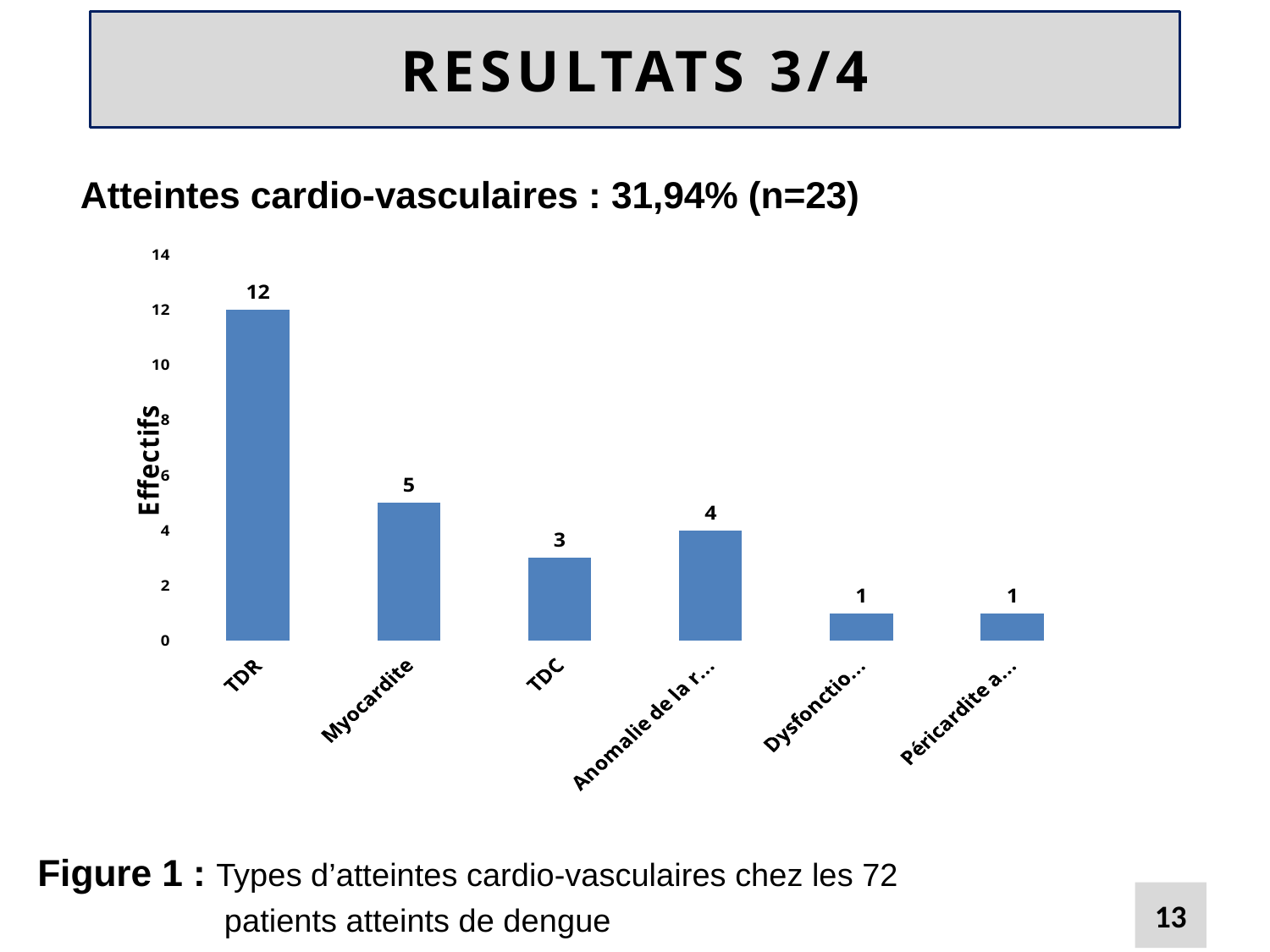
Which category has the highest value? TDR What is the difference between the values for TDR and Myocardite? 7 Is the value for TDR greater or less than 10? greater What is the value for TDC? 3 What is the label of the vertical axis? Effectifs What is the value for TDR? 12 What is the difference between the values for Myocardite and TDC? 2 What is the lowest value shown on the chart? 1 What is the value for Myocardite? 5 Which is larger, the value for Myocardite or the value for TDC? Myocardite How many bars are shown on the chart? 6 What type of chart is shown on the slide? bar chart